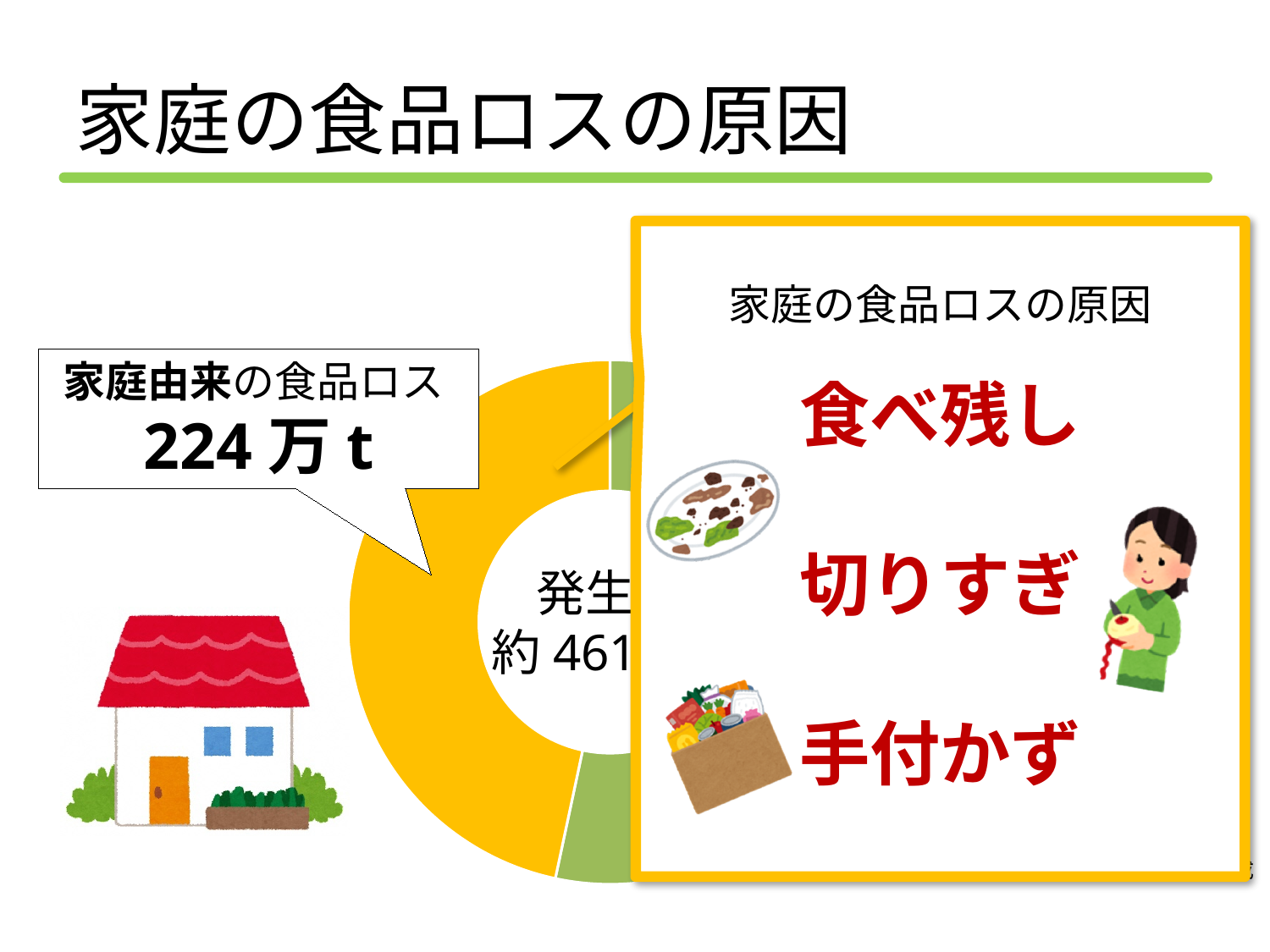
What colour is the segment labelled 家庭由来の食品ロス? yellow What kind of chart is shown on the slide? doughnut chart How many differently coloured segments are visible in the chart? 2 What value is shown for 家庭由来の食品ロス on the chart? 224万t